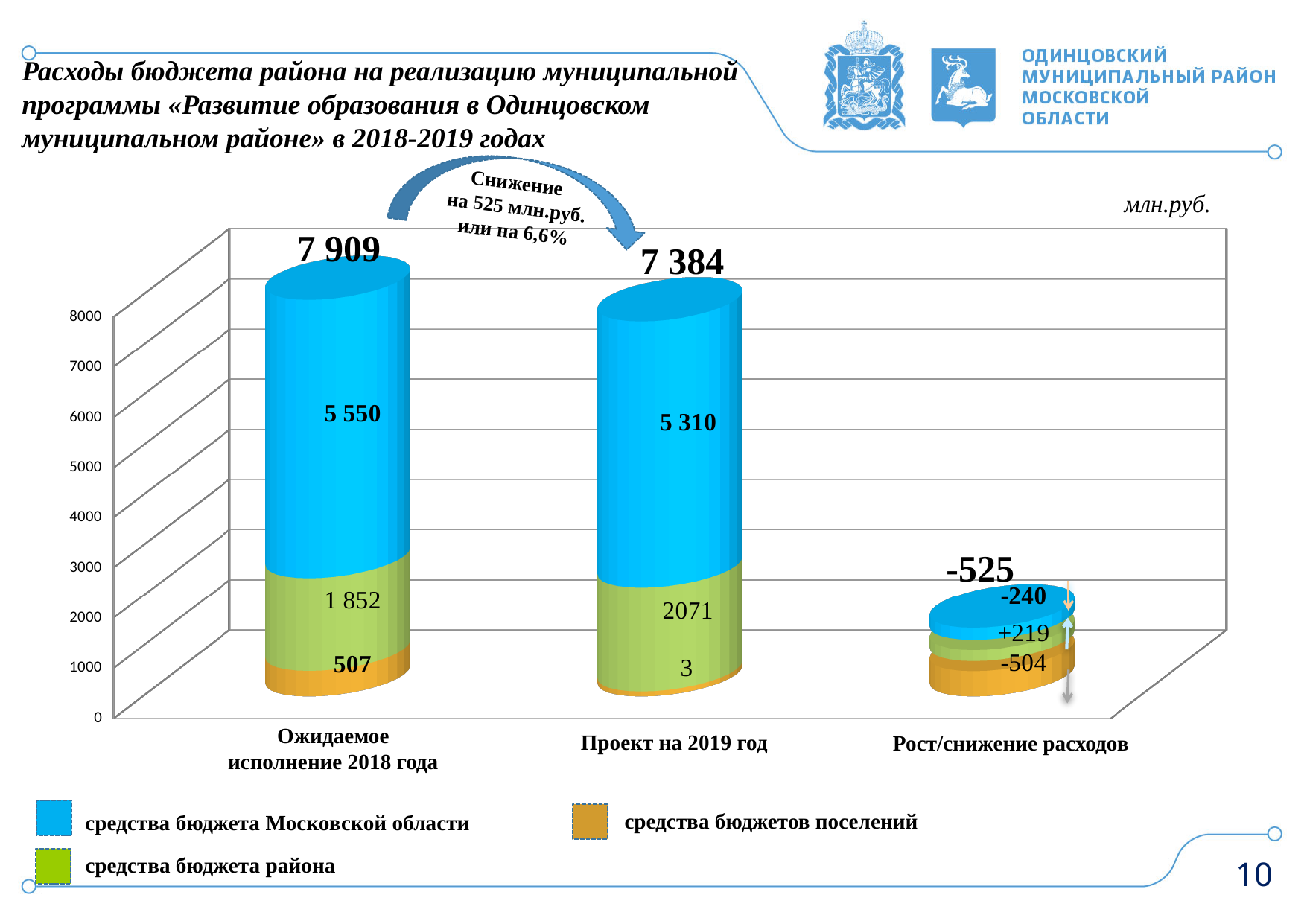
What is the total of the stacked bar for Проект на 2019 год? 7 384 How many series does the legend list? 3 Which is larger: средства бюджета района for Ожидаемое исполнение 2018 года or for Проект на 2019 год? Проект на 2019 год What is the value of средства бюджета Московской области for Ожидаемое исполнение 2018 года? 5 550 What unit is indicated for the values on the chart? млн.руб. What is the value of средства бюджета Московской области in the Рост/снижение расходов category? -240 What is the value of средства бюджетов поселений for Проект на 2019 год? 3 What is the difference between the средства бюджета Московской области values for 2018 (5 550) and 2019 (5 310)? 240 What is the value of средства бюджета района for Проект на 2019 год? 2071 What is the value of средства бюджетов поселений for Ожидаемое исполнение 2018 года? 507 What is the total of the stacked bar for Ожидаемое исполнение 2018 года? 7 909 What kind of chart is shown on the slide? Stacked bar chart